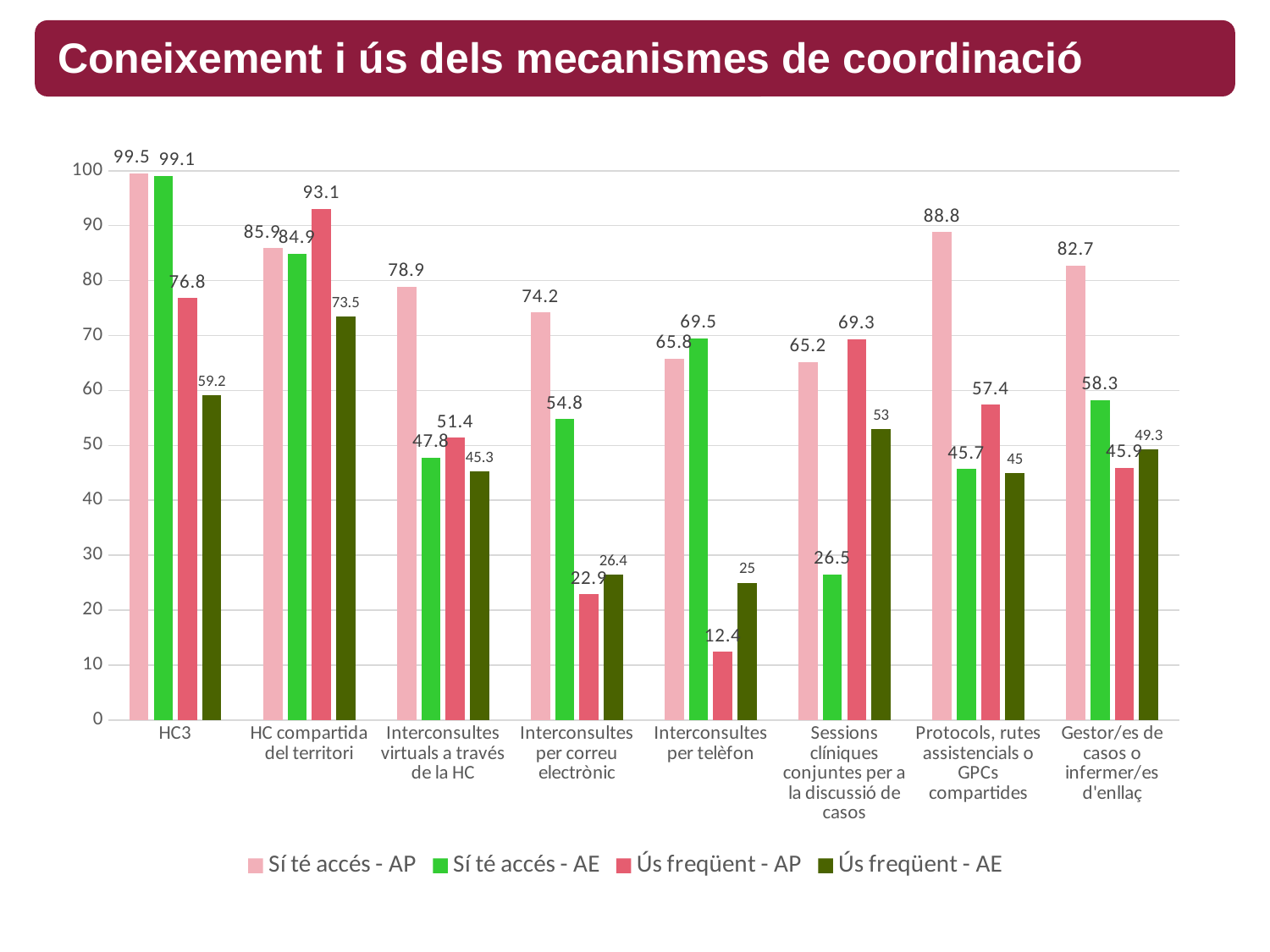
What is the value of "Ús freqüent - AP" for HC compartida del territori? 93.1 How many categories are shown on the x axis? 8 What is the title of the slide? Coneixement i ús dels mecanismes de coordinació What is the value of "Sí té accés - AP" for HC3? 99.5 What is the difference between "Sí té accés - AP" and "Ús freqüent - AP" for Interconsultes per correu electrònic? 51.3 How many series does the legend list? 4 Which category has the lowest value for "Ús freqüent - AP"? Interconsultes per telèfon Which category has the highest value for "Sí té accés - AE"? HC3 For Protocols, rutes assistencials o GPCs compartides, which is larger: "Sí té accés - AE" or "Ús freqüent - AP"? Ús freqüent - AP What is the value of "Ús freqüent - AE" for Interconsultes per telèfon? 25 What type of chart is shown on the slide? Bar chart What is the value of "Sí té accés - AE" for Sessions clíniques conjuntes per a la discussió de casos? 26.5